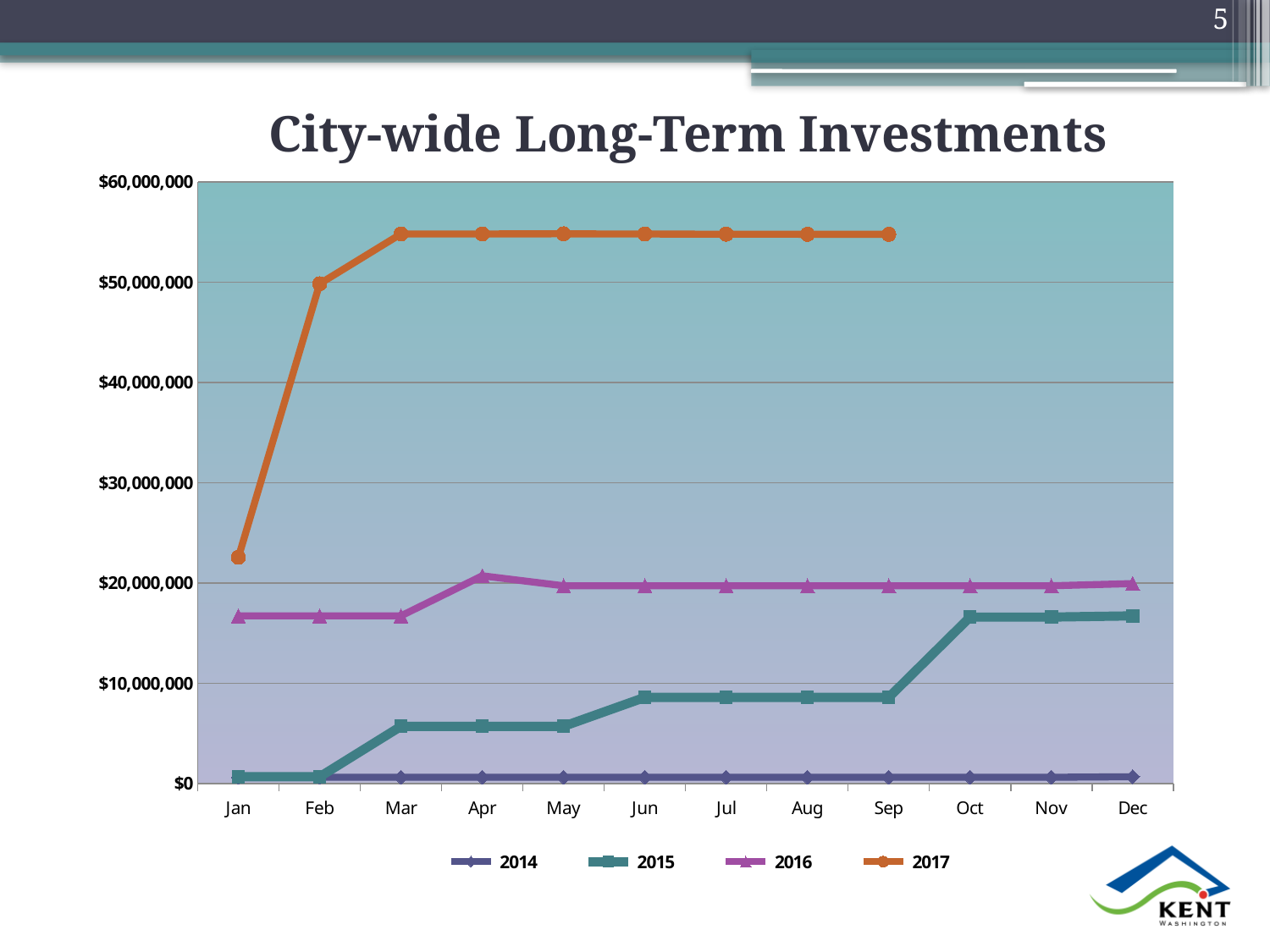
Is the value for 2016 in Jun greater or less than $10,000,000? greater Is the value for 2015 in Mar greater or less than $10,000,000? less How many months are shown along the x axis? 12 In Jun, which series has the larger value, 2015 or 2016? 2016 Does the 2015 series rise or fall from Jan to Dec? rise How many series does the legend list? 4 Is the value for 2017 in Mar greater or less than $50,000,000? greater In Feb, which series has the larger value, 2017 or 2016? 2017 Which series has the highest value in Sep? 2017 Which series has the lowest value in Dec? 2014 What kind of chart is shown on the slide? line chart